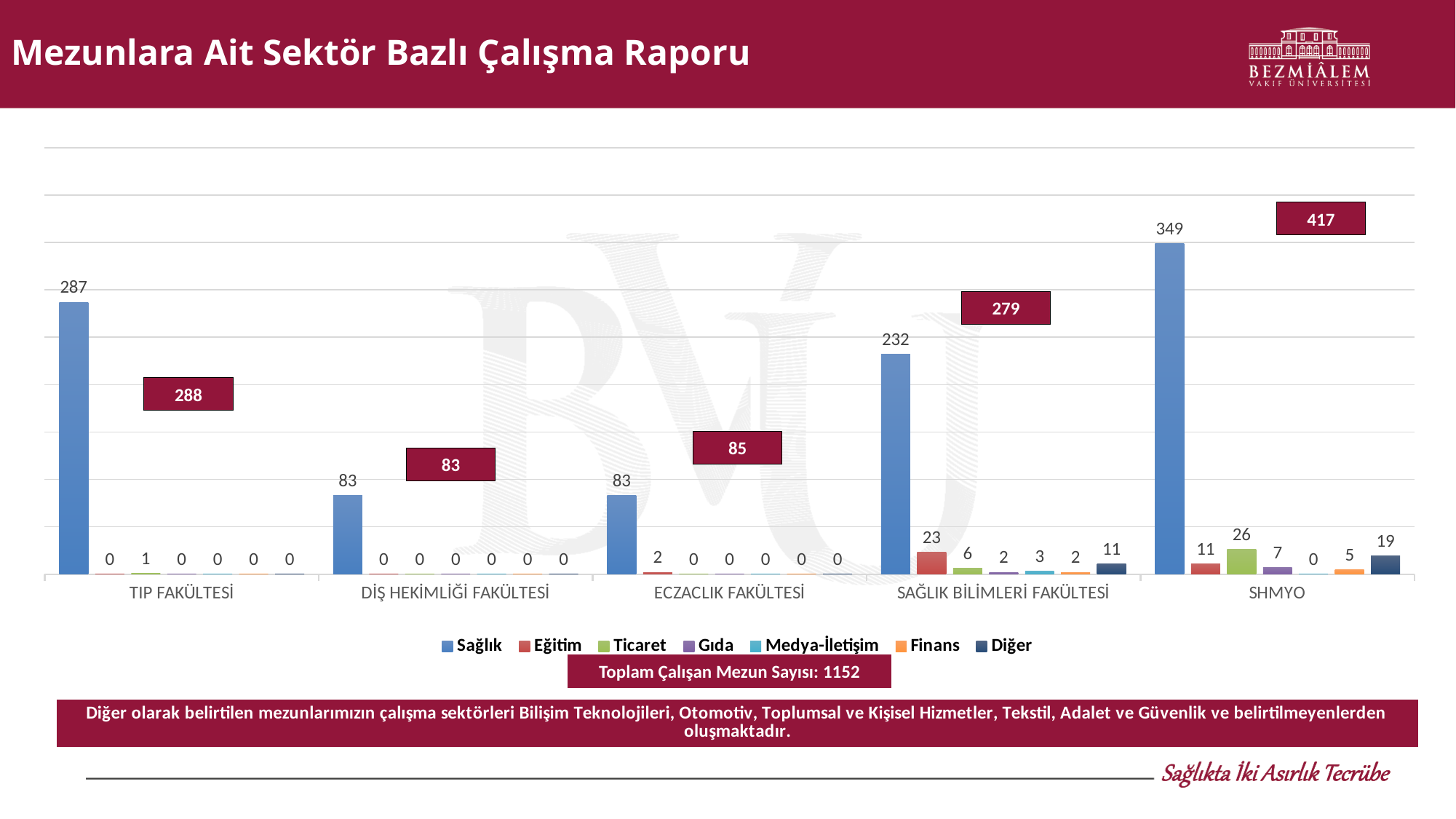
Which is larger, the Eğitim value for SAĞLIK BİLİMLERİ FAKÜLTESİ or the Eğitim value for SHMYO? SAĞLIK BİLİMLERİ FAKÜLTESİ How many series does the legend list? 7 What is the Eğitim value for SAĞLIK BİLİMLERİ FAKÜLTESİ? 23 How many faculties are shown on the x axis? 5 What is the difference between the Sağlık values for SHMYO and SAĞLIK BİLİMLERİ FAKÜLTESİ? 117 What total number of working graduates is shown in the box below the legend? 1152 What is the Diğer value for SAĞLIK BİLİMLERİ FAKÜLTESİ? 11 Which faculty has the lowest Sağlık value? DİŞ HEKİMLİĞİ FAKÜLTESİ and ECZACLIK FAKÜLTESİ (both 83) Which faculty has the highest Sağlık value? SHMYO What is the Ticaret value for SHMYO? 26 What kind of chart is shown on the slide? Bar chart What is the Sağlık value for TIP FAKÜLTESİ? 287